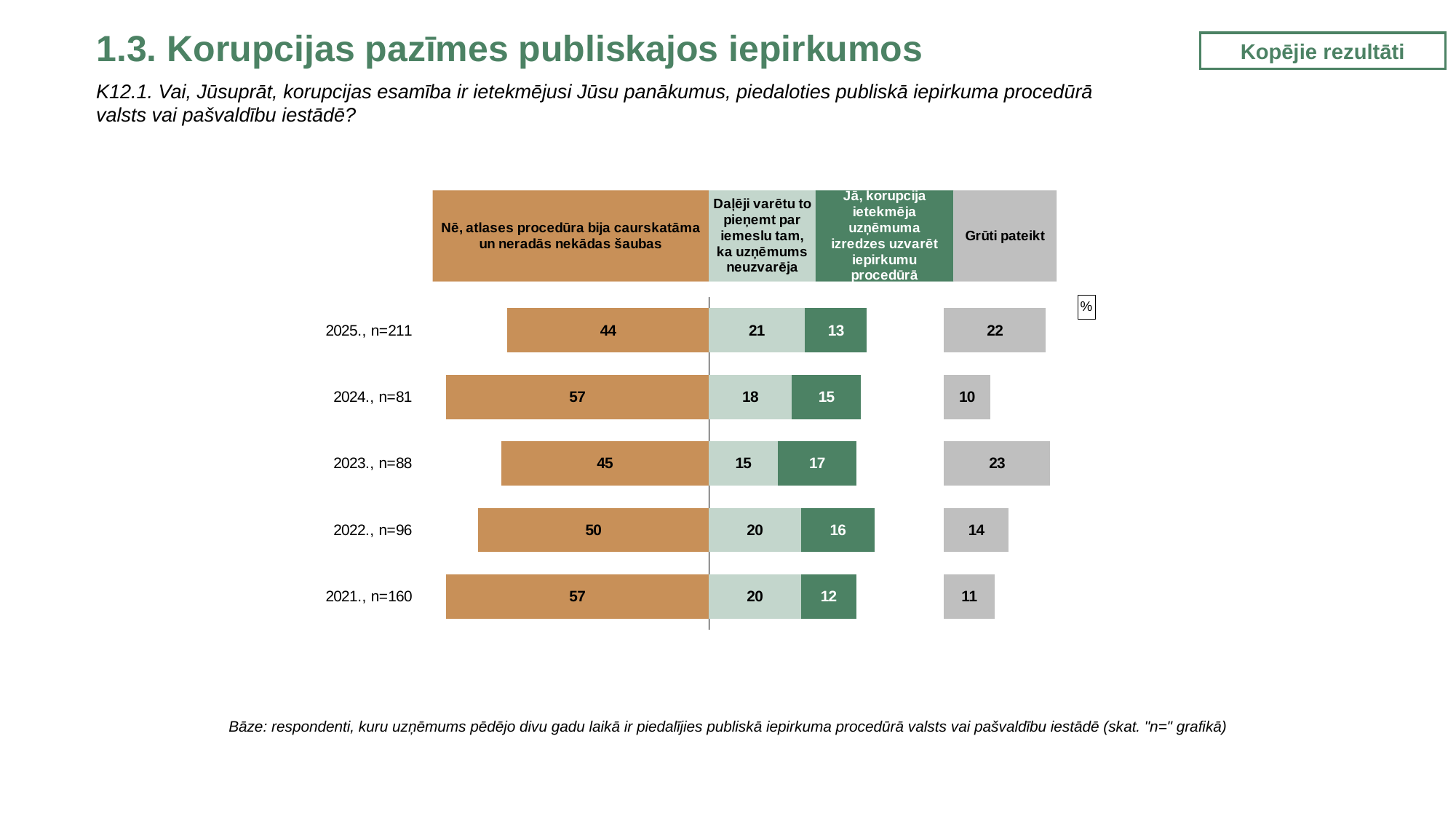
What type of chart is shown on the slide? Stacked bar chart In which year is the value for "Grūti pateikt" the highest? 2023., n=88 What is the value for "Jā, korupcija ietekmēja uzņēmuma izredzes uzvarēt iepirkumu procedūrā" in 2022., n=96? 16 In which year is the value for "Jā, korupcija ietekmēja uzņēmuma izredzes uzvarēt iepirkumu procedūrā" the highest? 2023., n=88 Which is larger: the "Daļēji varētu to pieņemt par iemeslu tam, ka uzņēmums neuzvarēja" value in 2025., n=211 or in 2023., n=88? 2025., n=211 What is the difference between the "Nē, atlases procedūra bija caurskatāma un neradās nekādas šaubas" value and the "Grūti pateikt" value in 2025., n=211? 22 What is the value for "Grūti pateikt" in 2024., n=81? 10 How many year categories are shown in the chart? 5 What is the total of all four segments for 2021., n=160? 100 What is the value for "Nē, atlases procedūra bija caurskatāma un neradās nekādas šaubas" in 2025., n=211? 44 How many series does the chart legend list? 4 In which year is the value for "Nē, atlases procedūra bija caurskatāma un neradās nekādas šaubas" the lowest? 2025., n=211